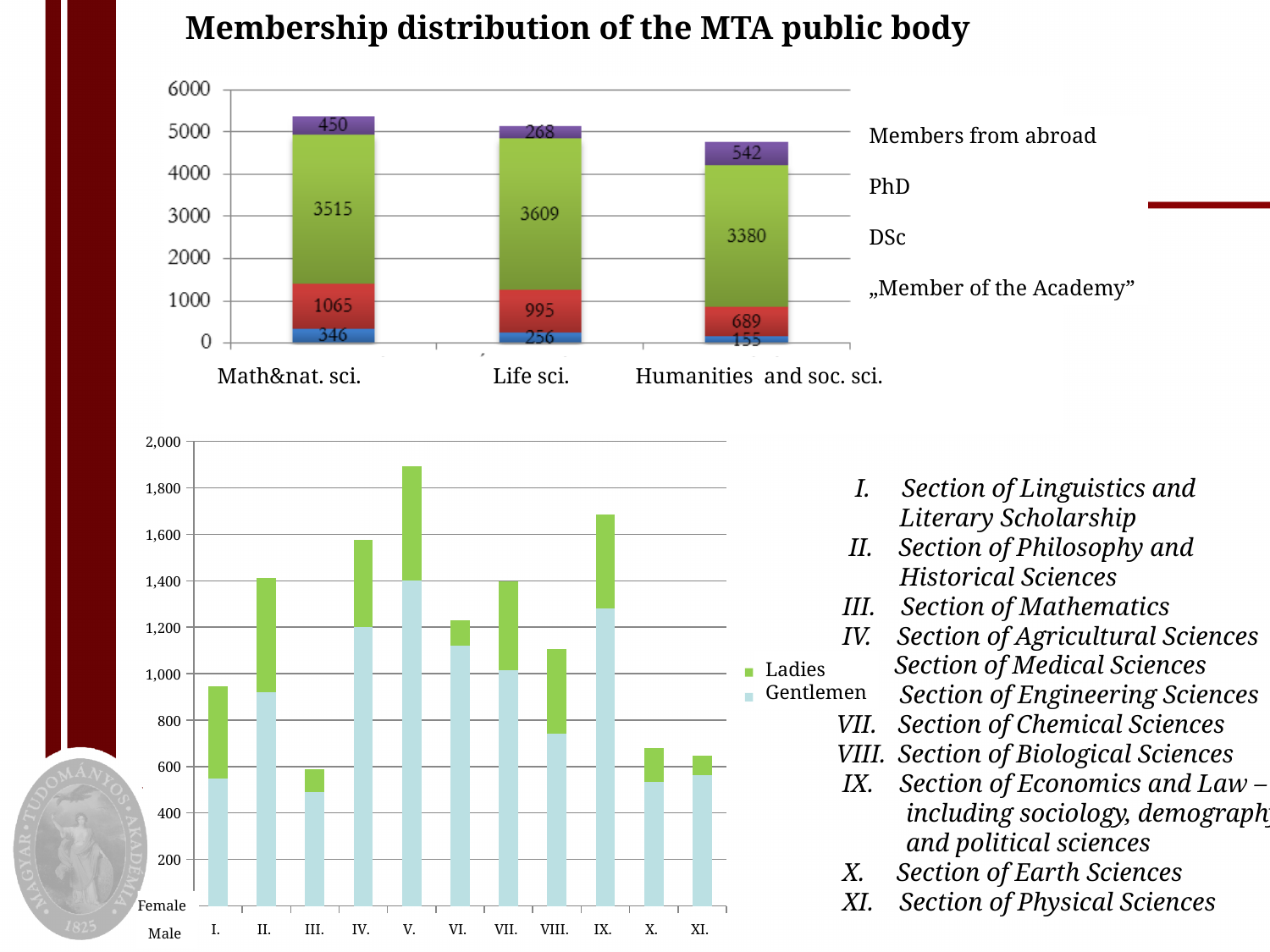
In the top chart, what is the difference between the green segment values for Life sci. and Math&nat. sci.? 94 In the top chart, what is the total of the stacked bar for Humanities and soc. sci.? 4766 In the bottom chart, which section has the shortest stacked bar? III. In the top chart (Membership distribution of the MTA public body), what is the value of the green segment for Life sci.? 3609 What kind of chart is the bottom chart? Stacked bar chart In the top chart, what is the value of the bottom (blue) segment for Math&nat. sci.? 346 In the bottom chart, which section has the tallest stacked bar? V. In the top chart, which category has the larger red segment, Math&nat. sci. or Life sci.? Math&nat. sci. In the top chart, what is the value of the top (purple) segment for Humanities and soc. sci.? 542 In the bottom chart, how many series does the legend list? 2 In the bottom chart, is the total bar height for section IX. greater or less than 1,600? greater In the top chart, how many categories are shown on the x axis? 3